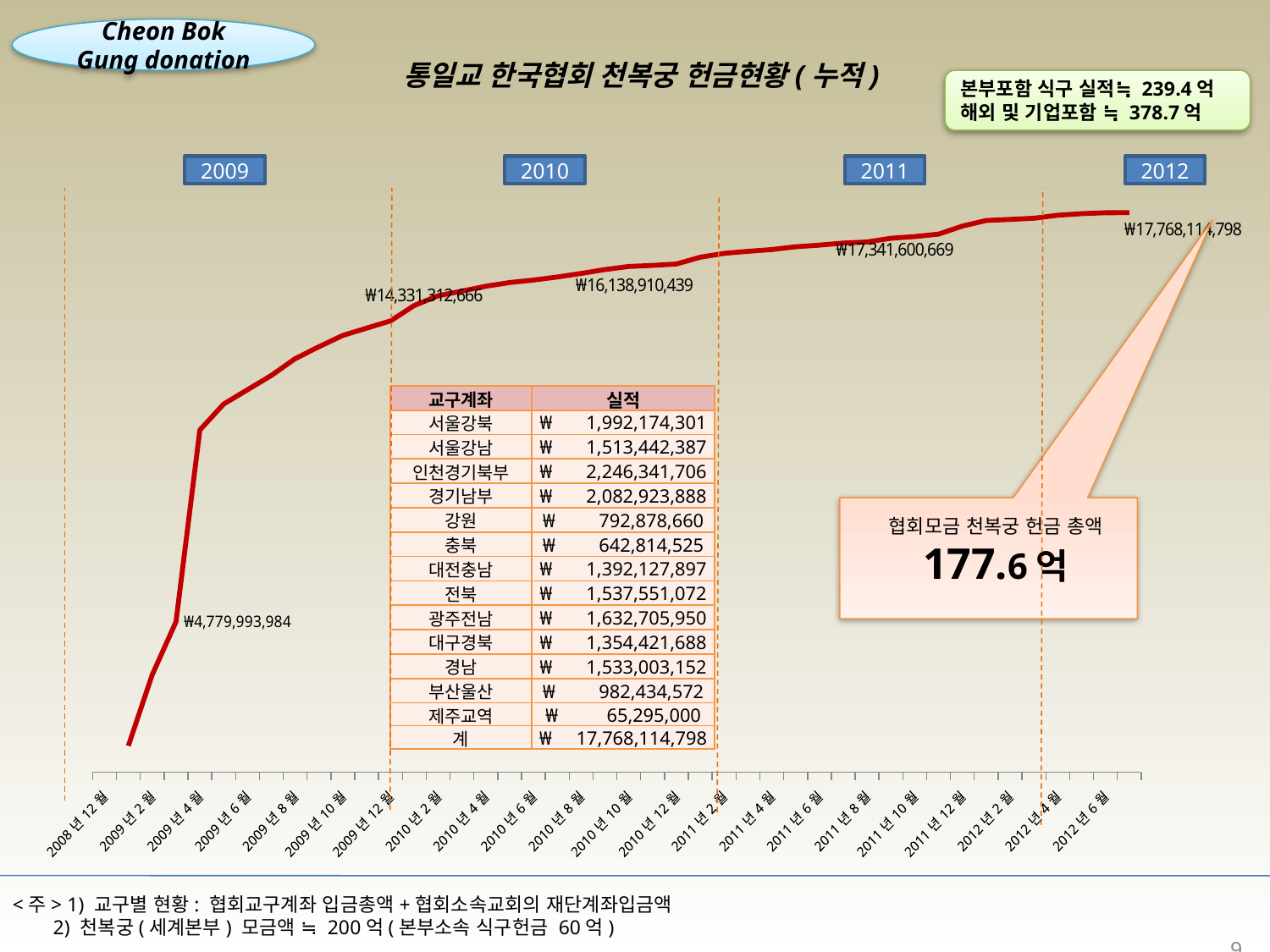
Does the plotted line rise or fall from 2008년 12월 to 2012년 6월? Rise What is the difference between the 2010 data label (₩16,138,910,439) and the second data label (₩14,331,312,666)? ₩1,807,597,773 What is the last (rightmost) data label value shown on the line? ₩17,768,114,798 What is the highest data label value shown on the chart? ₩17,768,114,798 What is the data label value shown in the 2011 section of the chart? ₩17,341,600,669 What is the title of the chart? 통일교 한국협회 천복궁 헌금현황 ( 누적 ) How many x-axis labels are shown along the bottom of the chart? 22 What is the second data label value shown on the line, near the 2009/2010 boundary? ₩14,331,312,666 What is the data label value shown in the 2010 section of the chart? ₩16,138,910,439 What is the first (lowest) data label value shown on the line? ₩4,779,993,984 What type of chart is shown on the slide? Line chart What is the difference between the last data label (₩17,768,114,798) and the 2011 data label (₩17,341,600,669)? ₩426,514,129